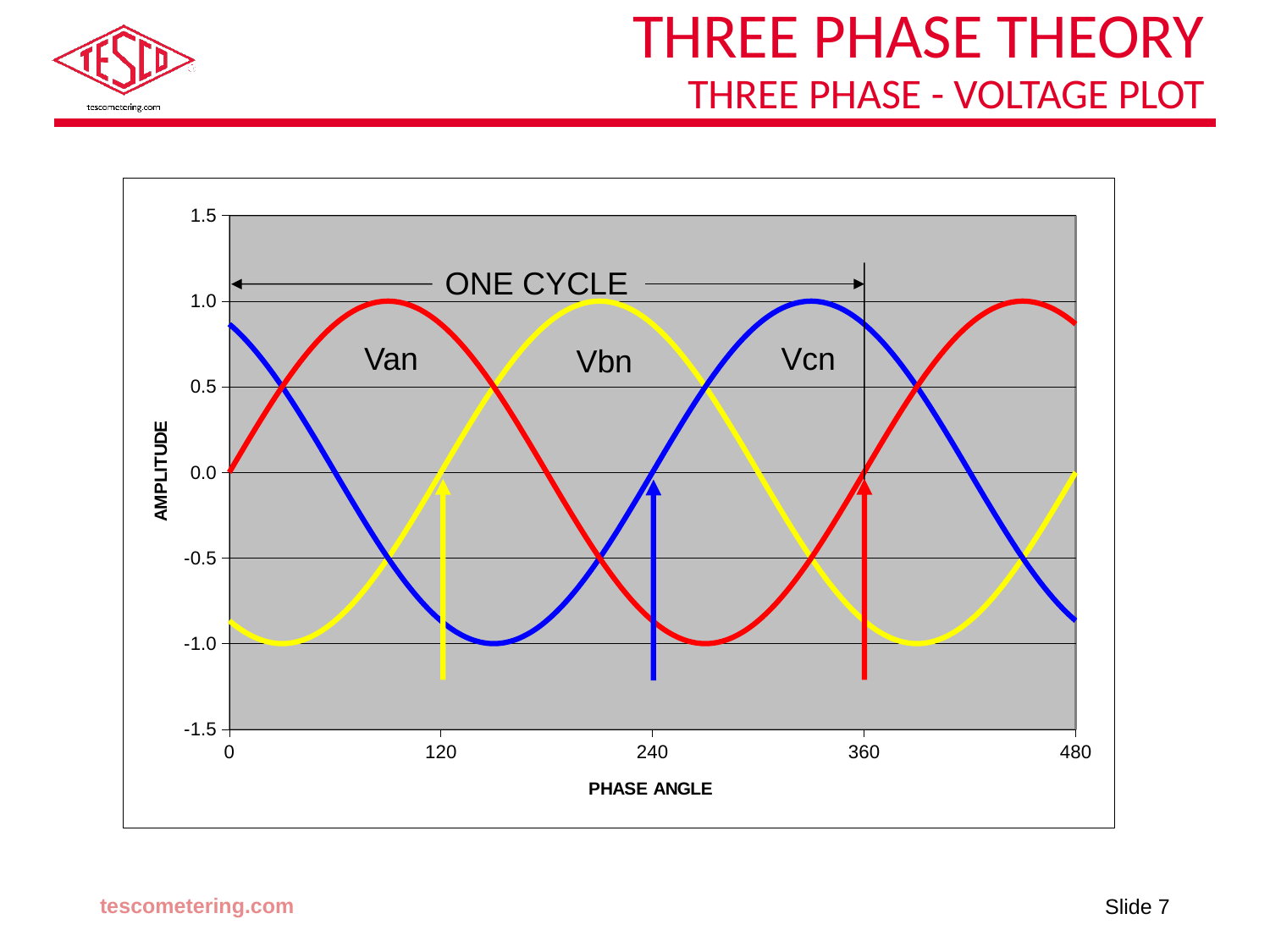
What is the amplitude of Vbn at a phase angle of 120? 0.0 Between phase angles 0 and 120, does the Vcn waveform rise or fall? fall At a phase angle of 0, which waveform has the larger amplitude, Van or Vcn? Vcn What is the amplitude of Van at a phase angle of 0? 0.0 Is the amplitude of Vcn at a phase angle of 0 greater or less than 0.5? greater How many voltage waveforms are plotted on the chart? 3 What kind of chart is shown on the slide? line chart What is the lowest amplitude reached by the Vbn waveform? -1.0 What is the amplitude of Vcn at a phase angle of 240? 0.0 What is the peak amplitude reached by the Van waveform? 1.0 What is the title of the x axis? PHASE ANGLE Is the amplitude of Vbn at a phase angle of 0 greater or less than -0.5? less